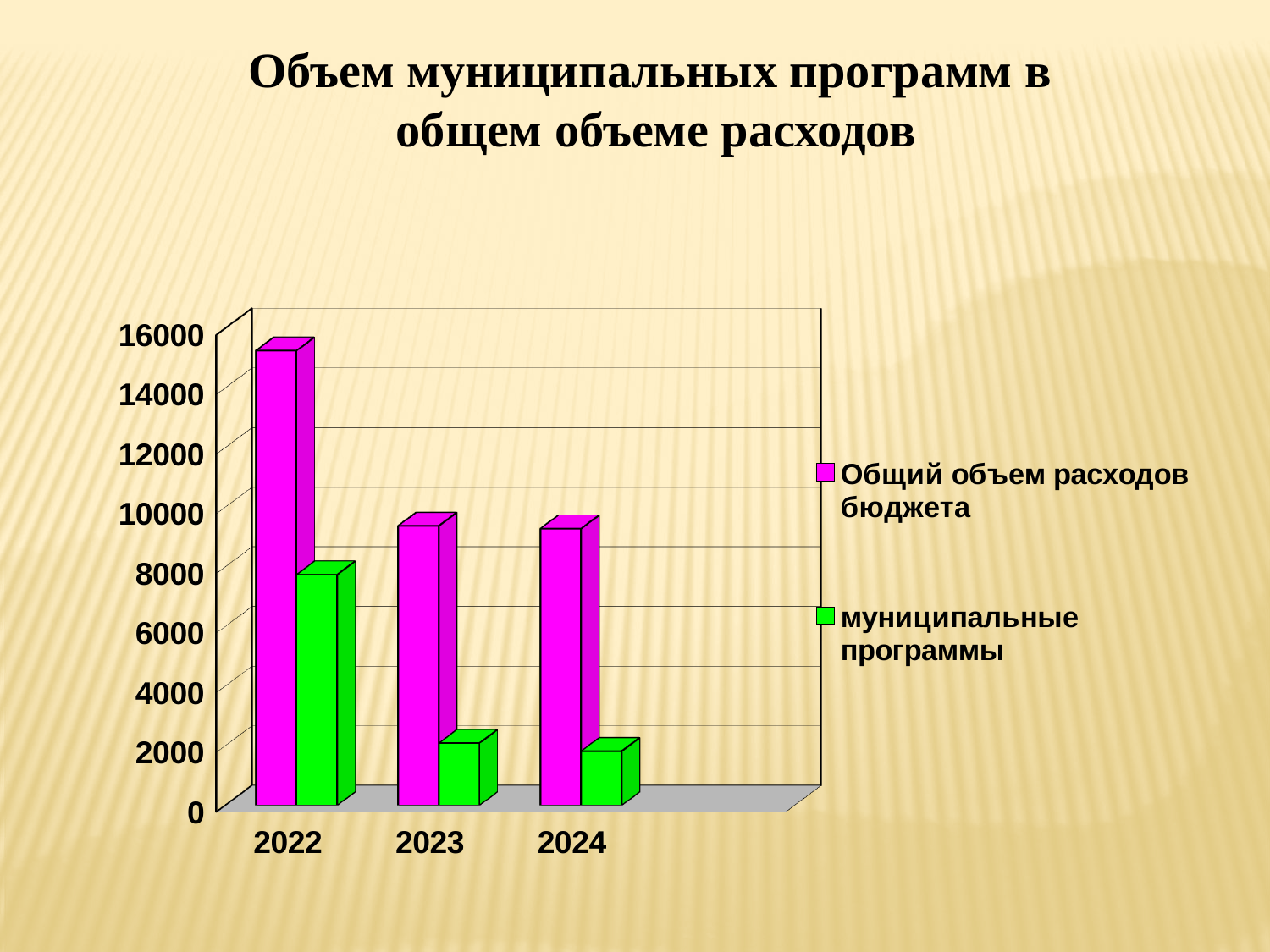
How many series does the legend list? 2 Which year has the highest value for "Общий объем расходов бюджета"? 2022 Which is larger: "Общий объем расходов бюджета" in 2022 or in 2023? 2022 Do the values for "муниципальные программы" rise or fall from 2022 to 2024? fall How many years are shown on the x axis? 3 Is the value for "Общий объем расходов бюджета" in 2022 greater or less than 14000? greater Is the value for "муниципальные программы" in 2022 greater or less than 6000? greater Is the value for "муниципальные программы" in 2024 greater or less than 4000? less What colour are the bars for "муниципальные программы"? green Which year has the highest value for "муниципальные программы"? 2022 What kind of chart is shown on the slide? bar chart